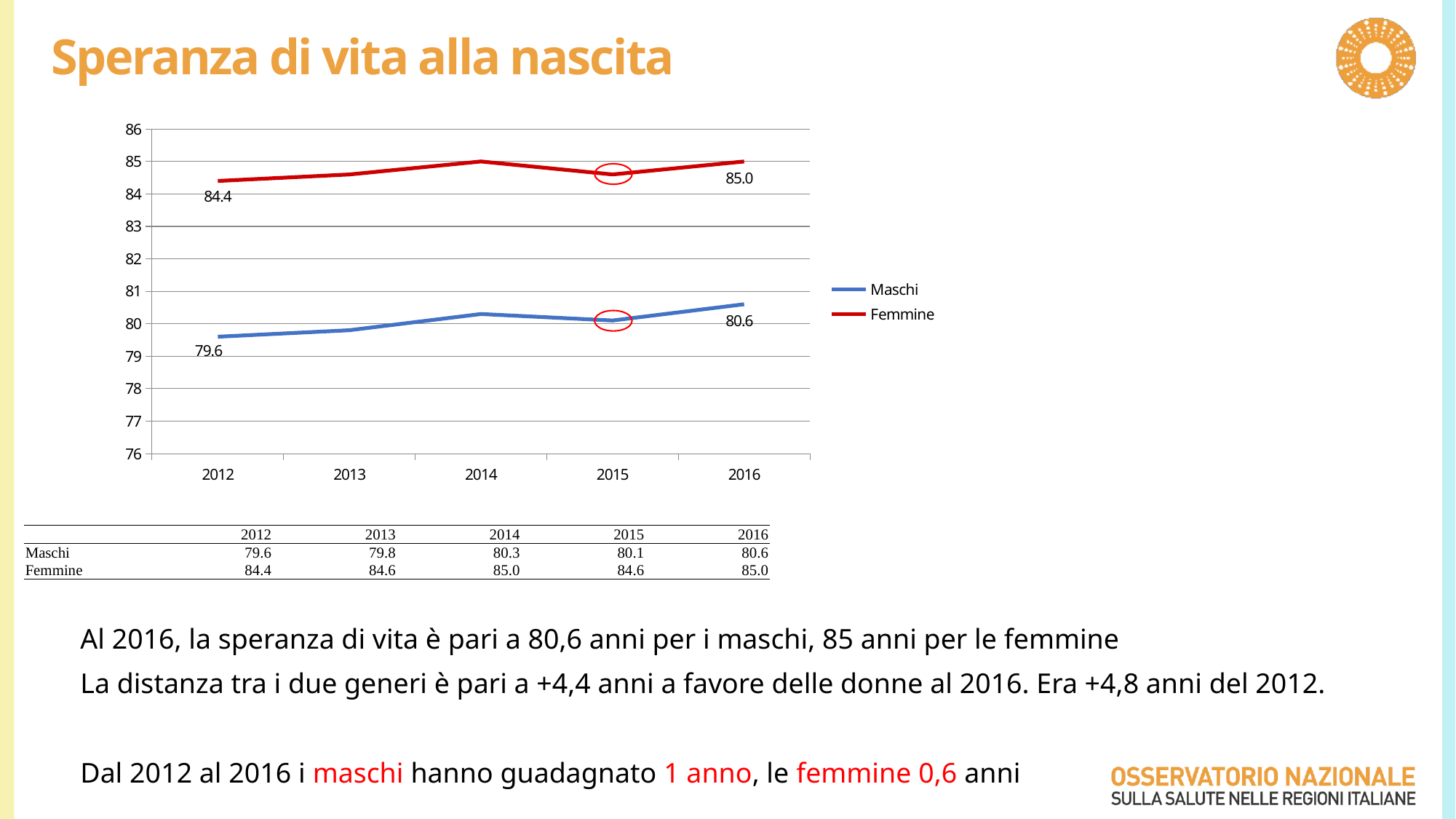
What is the difference between the Maschi value in 2016 and in 2012? 1.0 In which year is the Maschi series at its lowest? 2012 What is the value for Maschi in 2015 according to the data table? 80.1 How many years are plotted along the x axis? 5 What is the value for Maschi in 2012? 79.6 What is the value for Femmine in 2013 according to the data table? 84.6 What is the value for Femmine in 2016? 85.0 What kind of chart is shown on the slide? line chart What is the difference between Femmine and Maschi in 2016? 4.4 How many series does the legend list? 2 Which series has the higher value in 2014, Maschi or Femmine? Femmine Which colour is used for the Femmine line? red